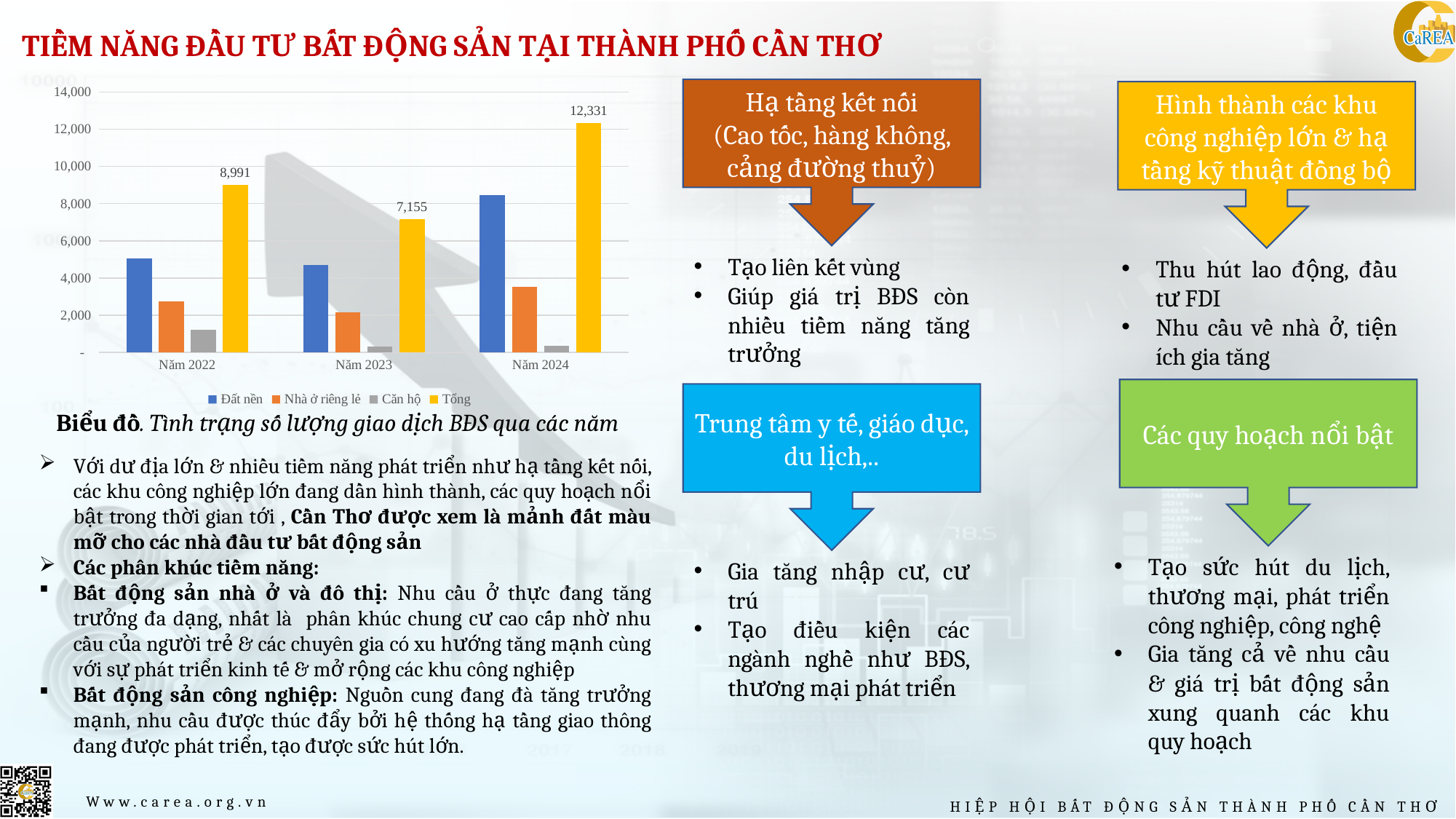
How many series does the chart legend list? 4 Is the value for Căn hộ in Năm 2022 greater or less than 2,000? less What is the value of Tổng for Năm 2023? 7,155 What is the value of Tổng for Năm 2022? 8,991 What is the difference between the Tổng values for Năm 2022 and Năm 2023? 1,836 What is the difference between the Tổng values for Năm 2024 and Năm 2022? 3,340 In which year is the Tổng value highest? Năm 2024 Is the value for Đất nền in Năm 2022 greater or less than 4,000? greater What is the value of Tổng for Năm 2024? 12,331 How many years are shown on the x axis of the chart? 3 In which year is the Tổng value lowest? Năm 2023 Which year has the larger Tổng value, Năm 2022 or Năm 2023? Năm 2022